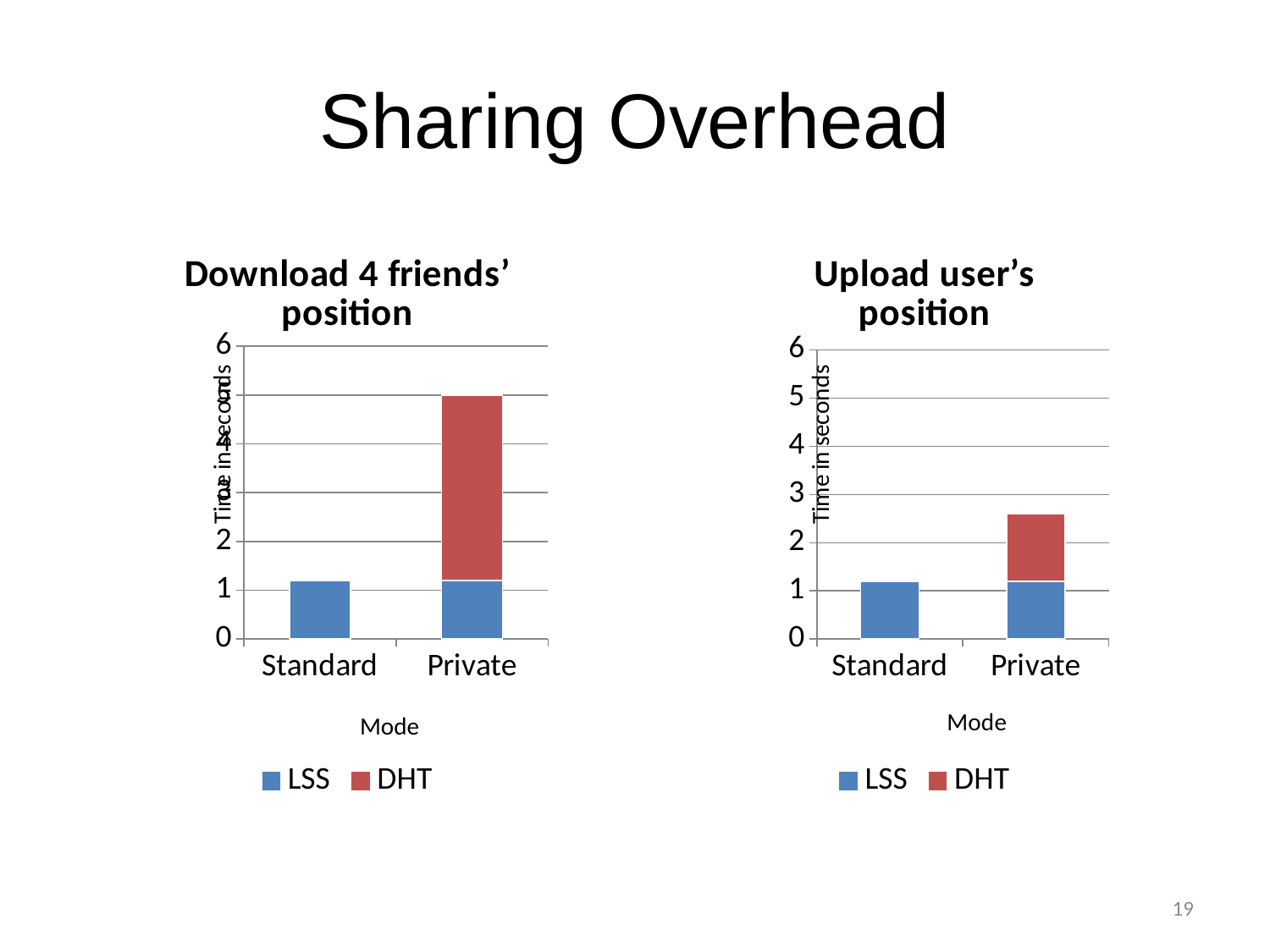
In the "Download 4 friends' position" chart, which series appears only in the Private bar and not in the Standard bar? DHT In the "Download 4 friends' position" chart, is the total stacked value for Private greater or less than 4? greater In the "Upload user's position" chart, is the total stacked value for Private greater or less than 2? greater What is the y-axis label on the "Upload user's position" chart? Time in seconds How many series does the legend of the "Download 4 friends' position" chart list? 2 In the "Upload user's position" chart, which mode has the lowest total bar? Standard In the "Download 4 friends' position" chart, is the value for Standard greater or less than 2? less How many categories are shown on the x axis of the "Upload user's position" chart? 2 What kind of chart is the "Download 4 friends' position" chart? bar chart What are the two series named in the legend of the "Upload user's position" chart? LSS and DHT In the "Download 4 friends' position" chart, which mode has the higher total bar, Standard or Private? Private